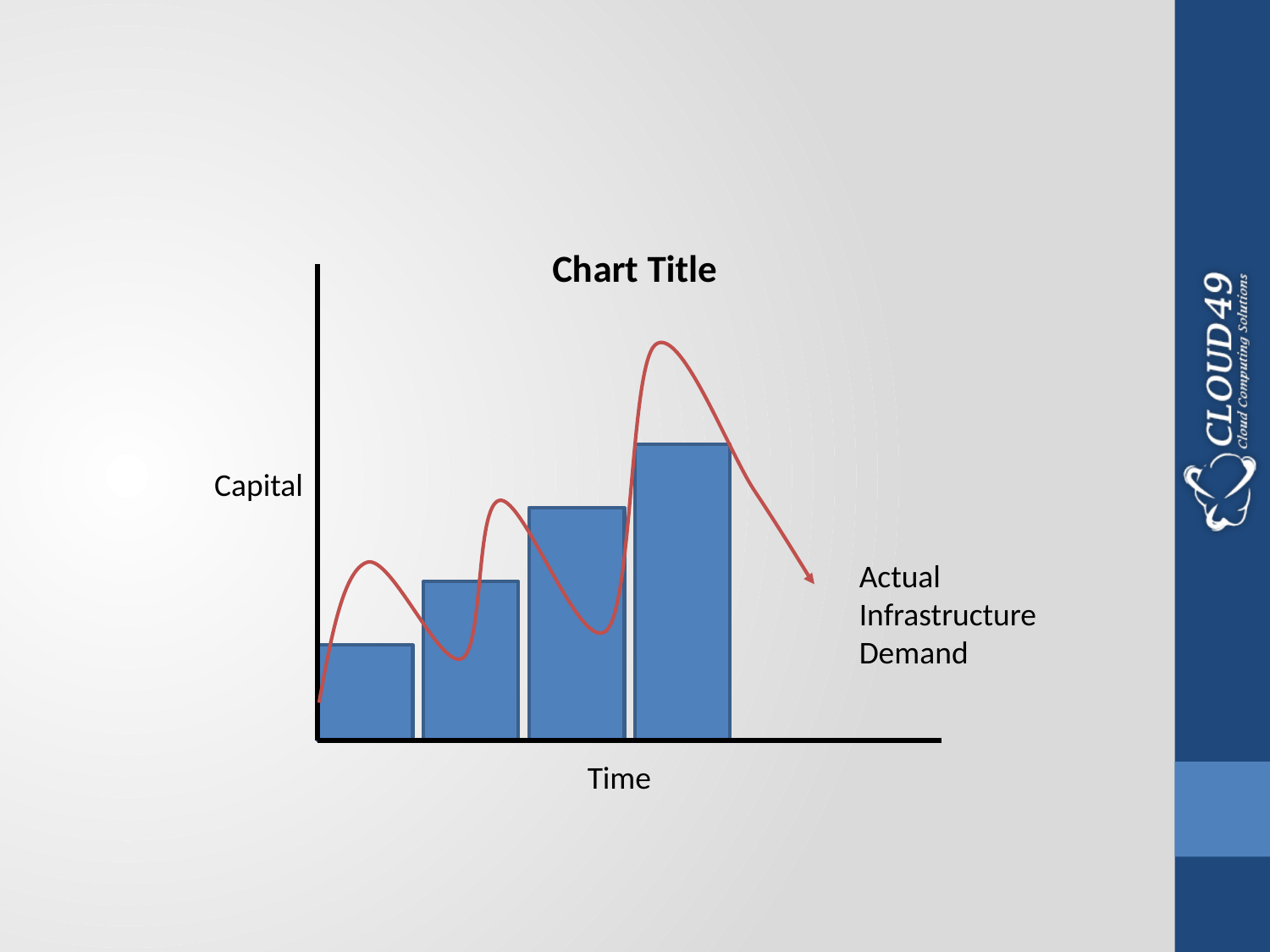
Which bar is the shortest in the chart? the leftmost (first) bar How many bars are plotted in the chart? 4 What does the red curved line in the chart represent? Actual Infrastructure Demand Which is taller, the leftmost bar or the rightmost bar? the rightmost bar Do the bar heights rise or fall from left to right along the Time axis? rise What kind of chart is shown on the slide? bar chart Which is taller, the second bar from the left or the third bar from the left? the third bar Which bar is the tallest in the chart? the rightmost (fourth) bar What is the title of the chart? Chart Title